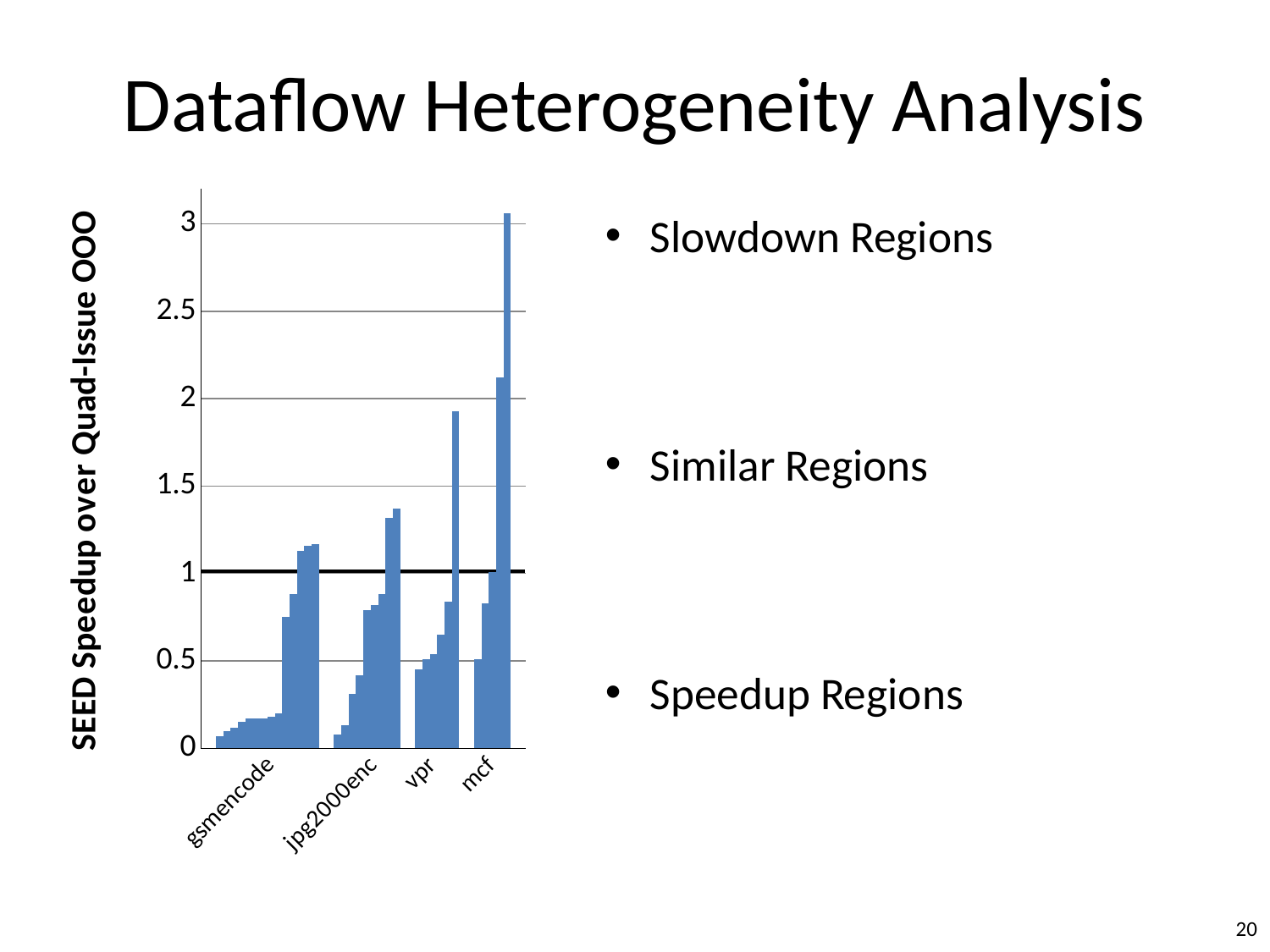
Which benchmark category contains the tallest bar? mcf What kind of chart is shown on the slide? bar chart Is the tallest bar for jpg2000enc greater or less than 1.5? less Which has a taller maximum bar, vpr or gsmencode? vpr What is the title of the y axis? SEED Speedup over Quad-Issue OOO Is the tallest bar for mcf greater or less than 2.5? greater At what y-axis value is the thick horizontal reference line drawn? 1 How many benchmark categories are labelled on the x axis? 4 Within each benchmark group, do the bars rise or fall from left to right? rise Is the tallest bar for vpr greater or less than 1.5? greater